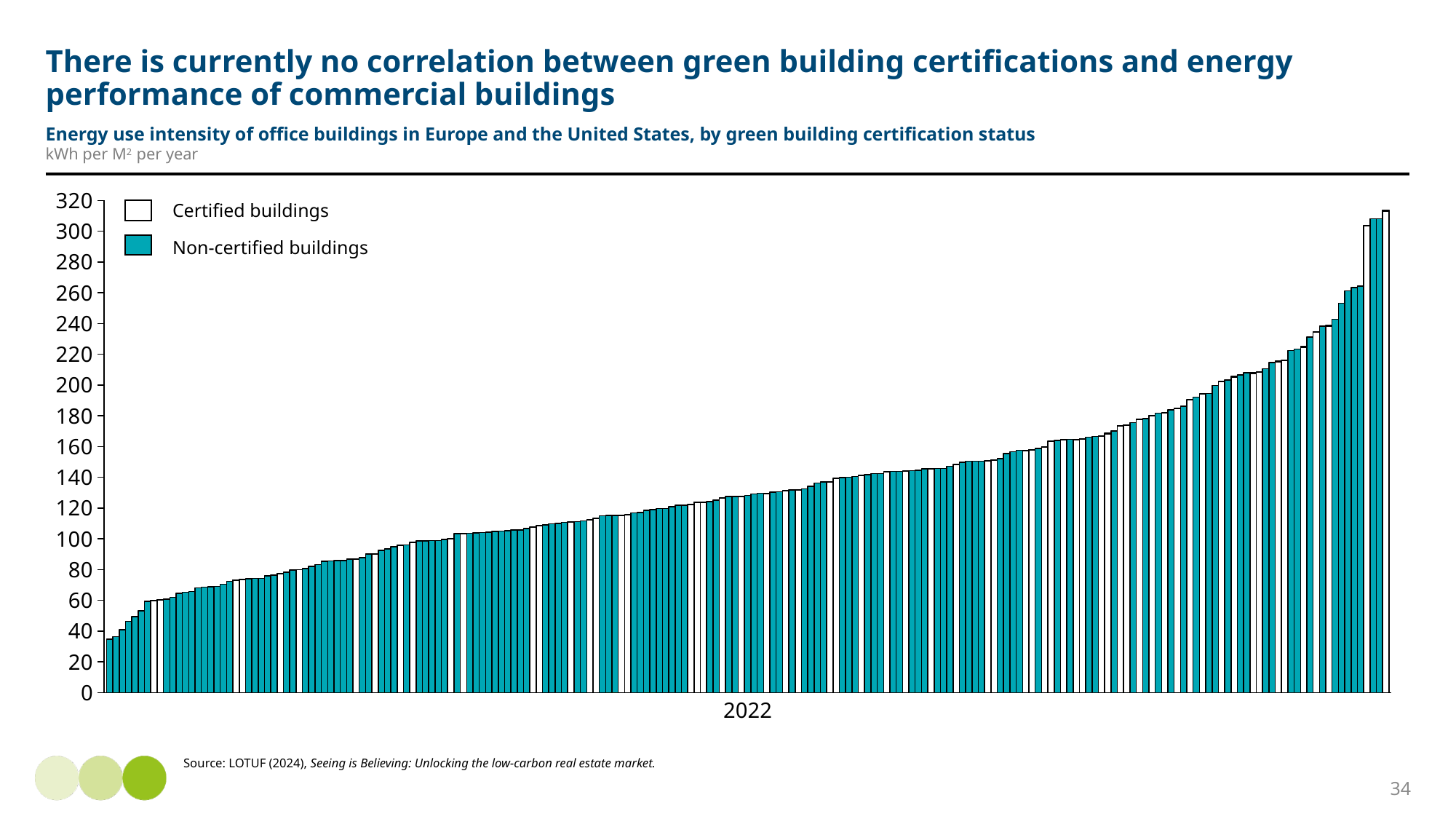
What unit is the y axis measured in, according to the subtitle? kWh per M² per year What is the highest value shown on the y axis? 320 Do the bar values rise or fall from left to right along the x axis? Rise How many series does the legend list? 2 Is the value of the shortest bar greater or less than 20? greater Is the value of the tallest bar greater or less than 300? greater What label appears on the x axis? 2022 Is the value of the tallest bar greater or less than 320? less What kind of chart is shown on the slide? Bar chart